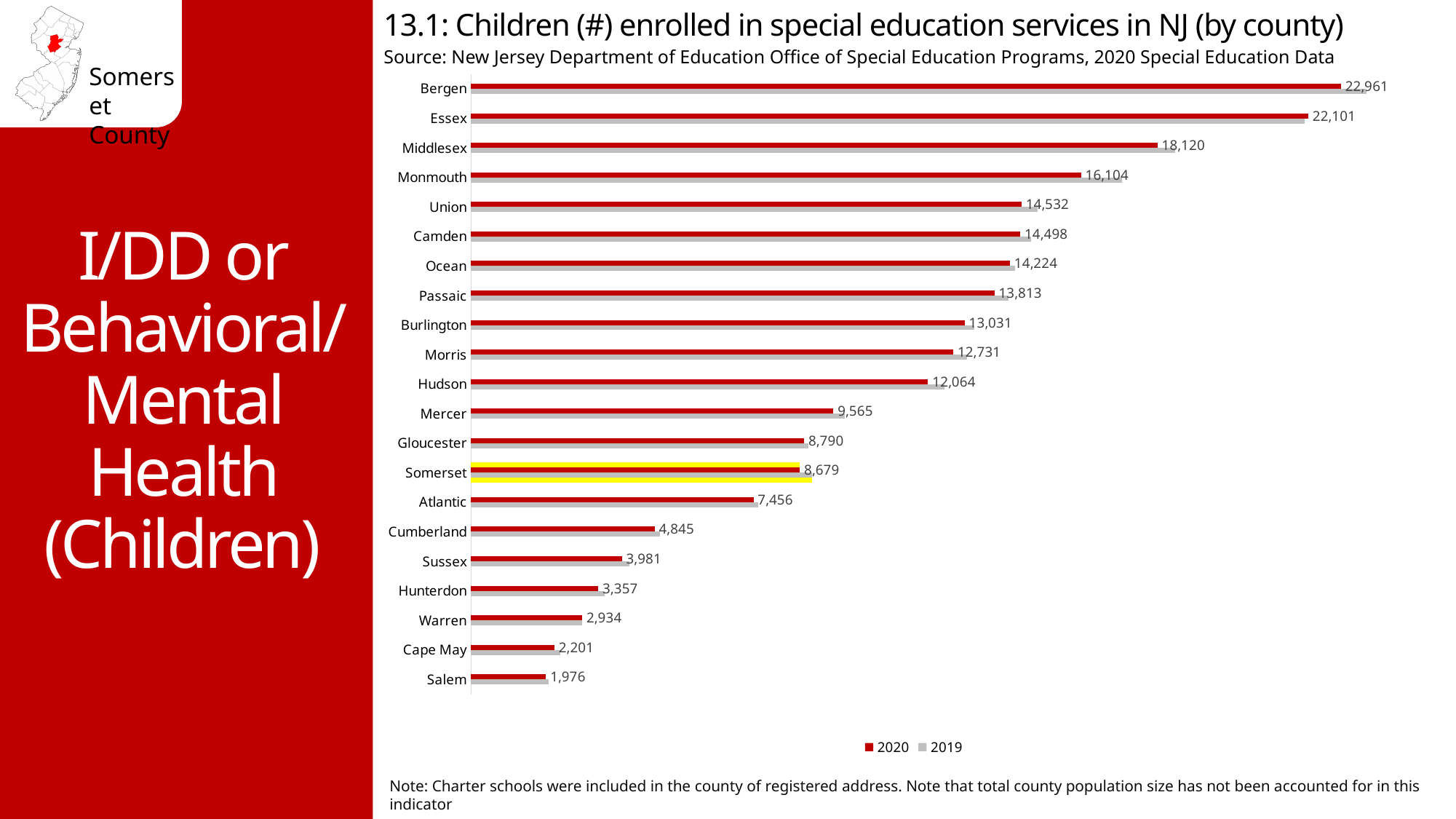
What is the difference between the 2020 values for Somerset and Atlantic? 1,223 What type of chart is shown on the slide? Bar chart Which series is shown in red in the legend? 2020 Which has a larger 2020 value, Mercer or Gloucester? Mercer Which county has the lowest 2020 value? Salem What is the 2020 value for Somerset? 8,679 What is the difference between the 2020 values for Bergen and Essex? 860 Which county has the highest 2020 value? Bergen What is the 2020 value for Cape May? 2,201 How many counties are listed in the chart? 21 What is the 2020 value for Middlesex? 18,120 How many series does the legend list? 2